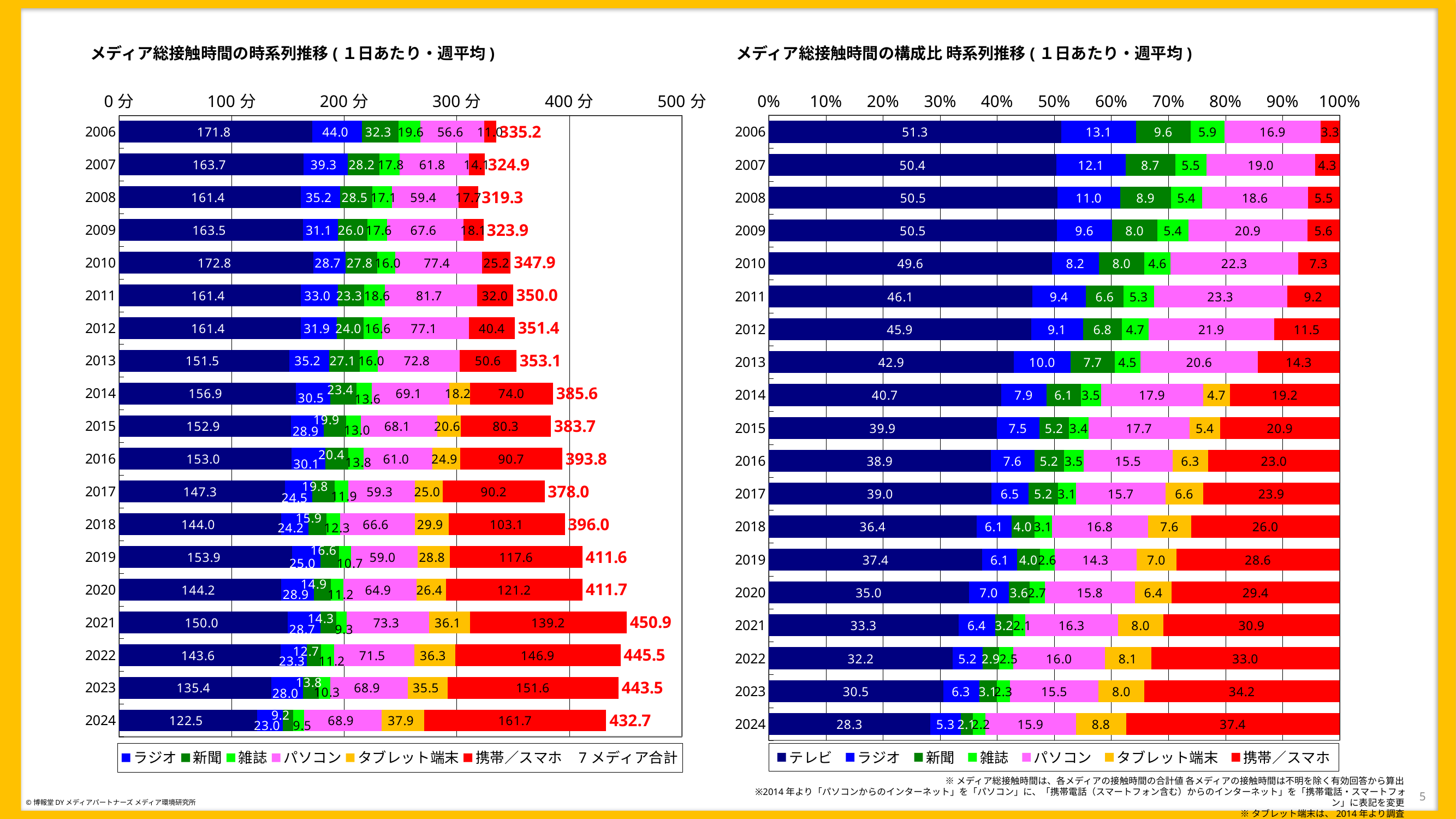
In the left chart (メディア総接触時間の時系列推移), which year has the highest 7メディア合計 value? 2021 In the right chart (メディア総接触時間の構成比 時系列推移), what is the 携帯／スマホ value for 2024? 37.4 In the left chart (メディア総接触時間の時系列推移), what is the 携帯／スマホ value for 2024? 161.7 In the left chart (メディア総接触時間の時系列推移), which year has the lowest 7メディア合計 value? 2008 In the right chart (メディア総接触時間の構成比 時系列推移), what is the difference between the 携帯／スマホ and テレビ values for 2024? 9.1 How many years are shown in the left chart (メディア総接触時間の時系列推移)? 19 How many series does the legend of the right chart (メディア総接触時間の構成比 時系列推移) list? 7 In the right chart (メディア総接触時間の構成比 時系列推移), what is the テレビ value for 2024? 28.3 What kind of chart is the right chart (メディア総接触時間の構成比 時系列推移)? Stacked bar chart In the left chart (メディア総接触時間の時系列推移), what is the difference between the 7メディア合計 values for 2024 and 2006? 97.5 In the left chart (メディア総接触時間の時系列推移), what is the 7メディア合計 value for 2024? 432.7 In the right chart (メディア総接触時間の構成比 時系列推移), which is larger: the テレビ value for 2006 or for 2024? 2006